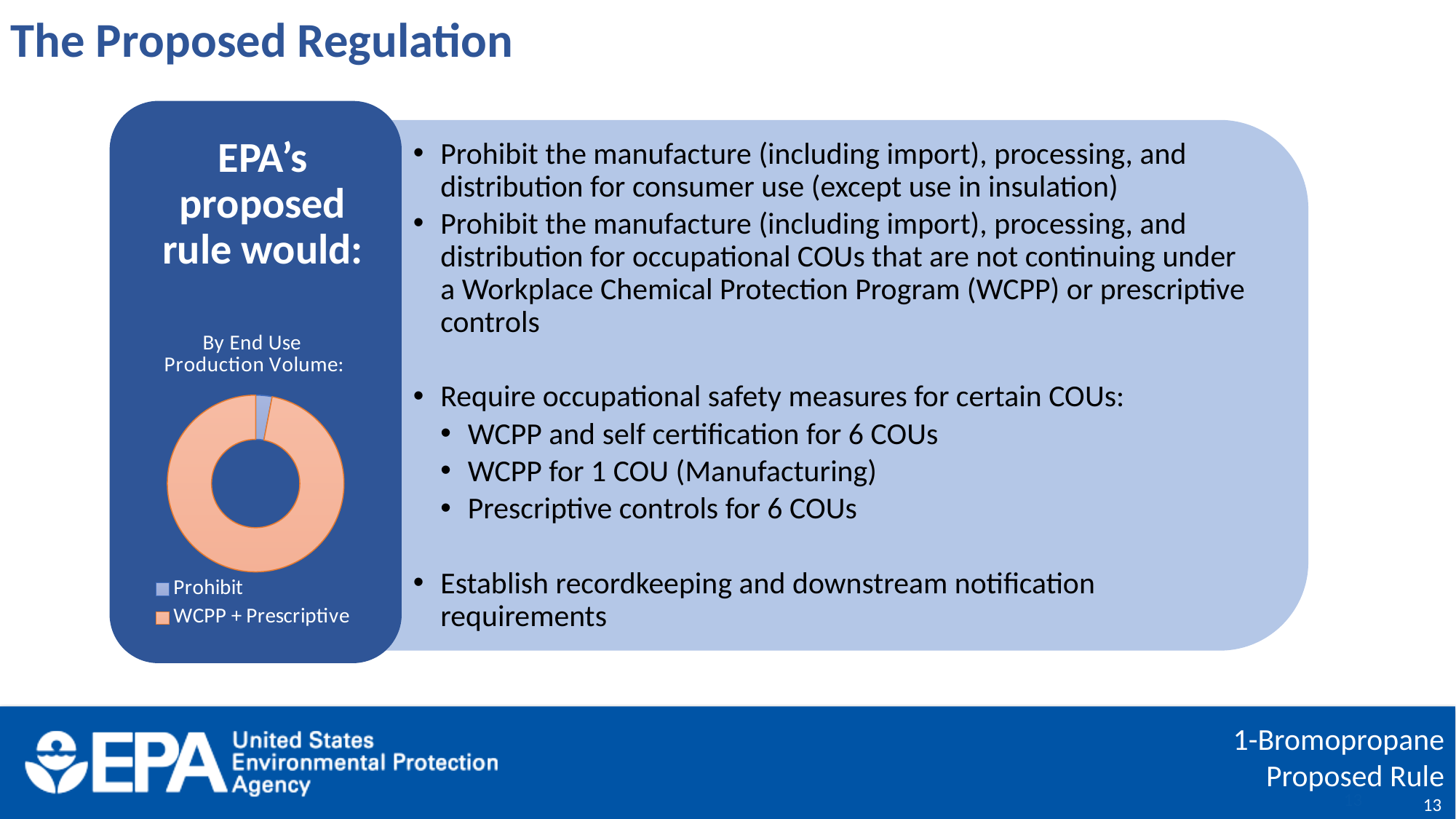
What colour represents the Prohibit category in the chart? Blue How many categories does the chart show? 2 Which category takes up the smallest share of the chart? Prohibit What is the title of the chart on the slide? By End Use Production Volume: What kind of chart is shown on the slide? Doughnut chart How many entries does the chart's legend list? 2 Which category takes up the largest share of the chart? WCPP + Prescriptive Which is larger in the chart, Prohibit or WCPP + Prescriptive? WCPP + Prescriptive